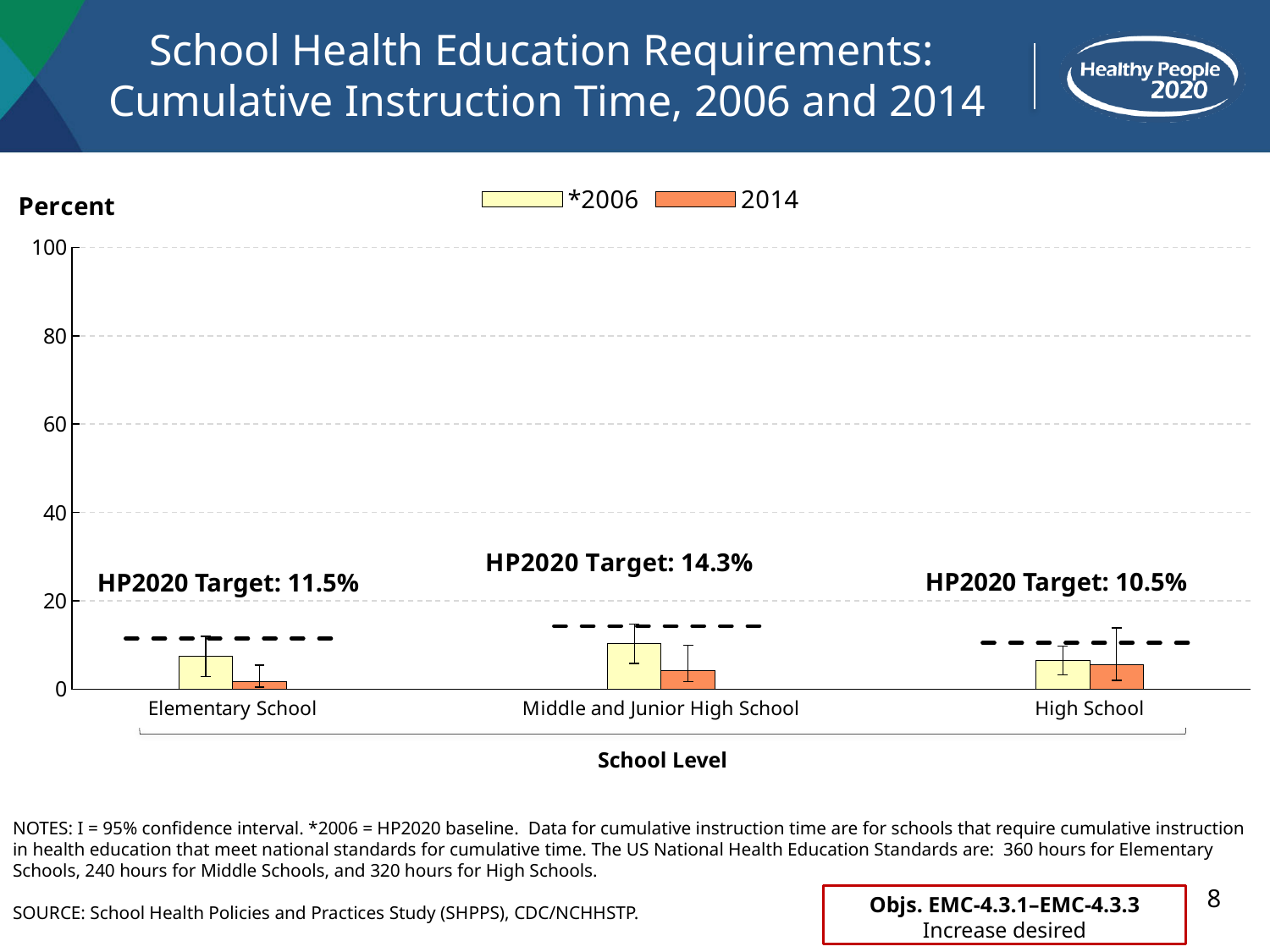
What is the HP2020 Target shown for High School? 10.5% What kind of chart is shown on the slide? Bar chart Which school level has the lowest 2014 value? Elementary School Which school level has the highest HP2020 Target? Middle and Junior High School What is the HP2020 Target shown for Elementary School? 11.5% What is the difference between the HP2020 Target for Middle and Junior High School and the HP2020 Target for Elementary School? 2.8 percentage points For Elementary School, which is larger, the 2006 value or the 2014 value? 2006 What is the HP2020 Target shown for Middle and Junior High School? 14.3% Is the 2006 value for Middle and Junior High School greater or less than 20? less How many school levels are shown on the x axis? 3 How many series does the legend list? 2 What are the two series named in the legend? *2006 and 2014